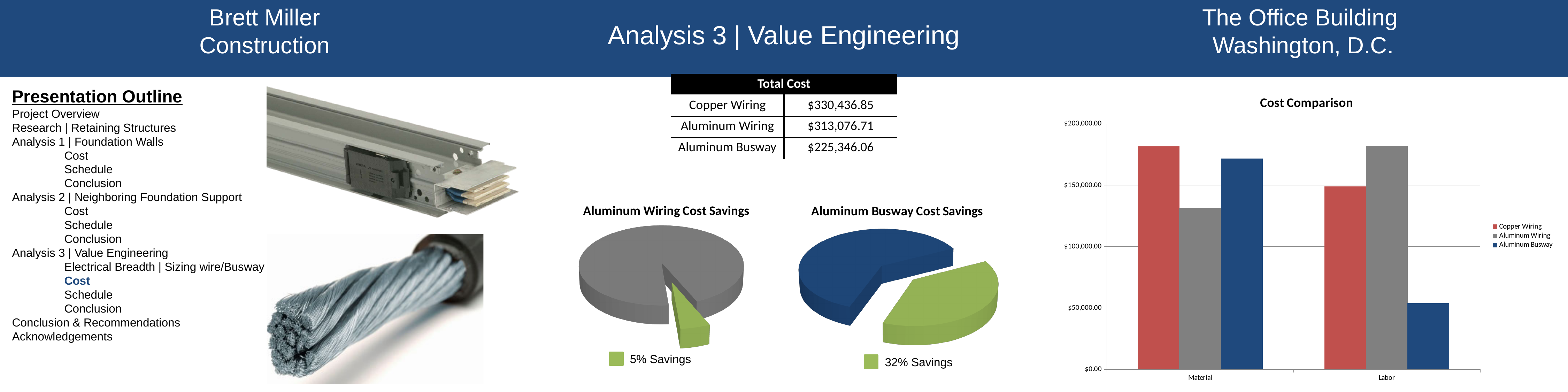
In the Cost Comparison chart, which series has the highest value for Labor? Aluminum Wiring In the Cost Comparison chart, how many series does the legend list? 3 In the Cost Comparison chart, is the Aluminum Busway value larger for Material or for Labor? Material In the Cost Comparison chart, which series has the highest value for Material? Copper Wiring In the Cost Comparison chart, is the Copper Wiring value for Material greater or less than $150,000.00? greater In the Cost Comparison chart, which series has the lowest value for Labor? Aluminum Busway In the Aluminum Busway Cost Savings pie chart, what share does the savings slice represent? 32% In the Cost Comparison chart, is the Aluminum Busway value for Labor greater or less than $100,000.00? less In the Aluminum Wiring Cost Savings pie chart, what share does the savings slice represent? 5% In the Cost Comparison chart, how many categories are shown on the x axis? 2 In the Cost Comparison chart, is the Aluminum Wiring value for Material greater or less than $150,000.00? less What kind of chart is the Cost Comparison chart? bar chart